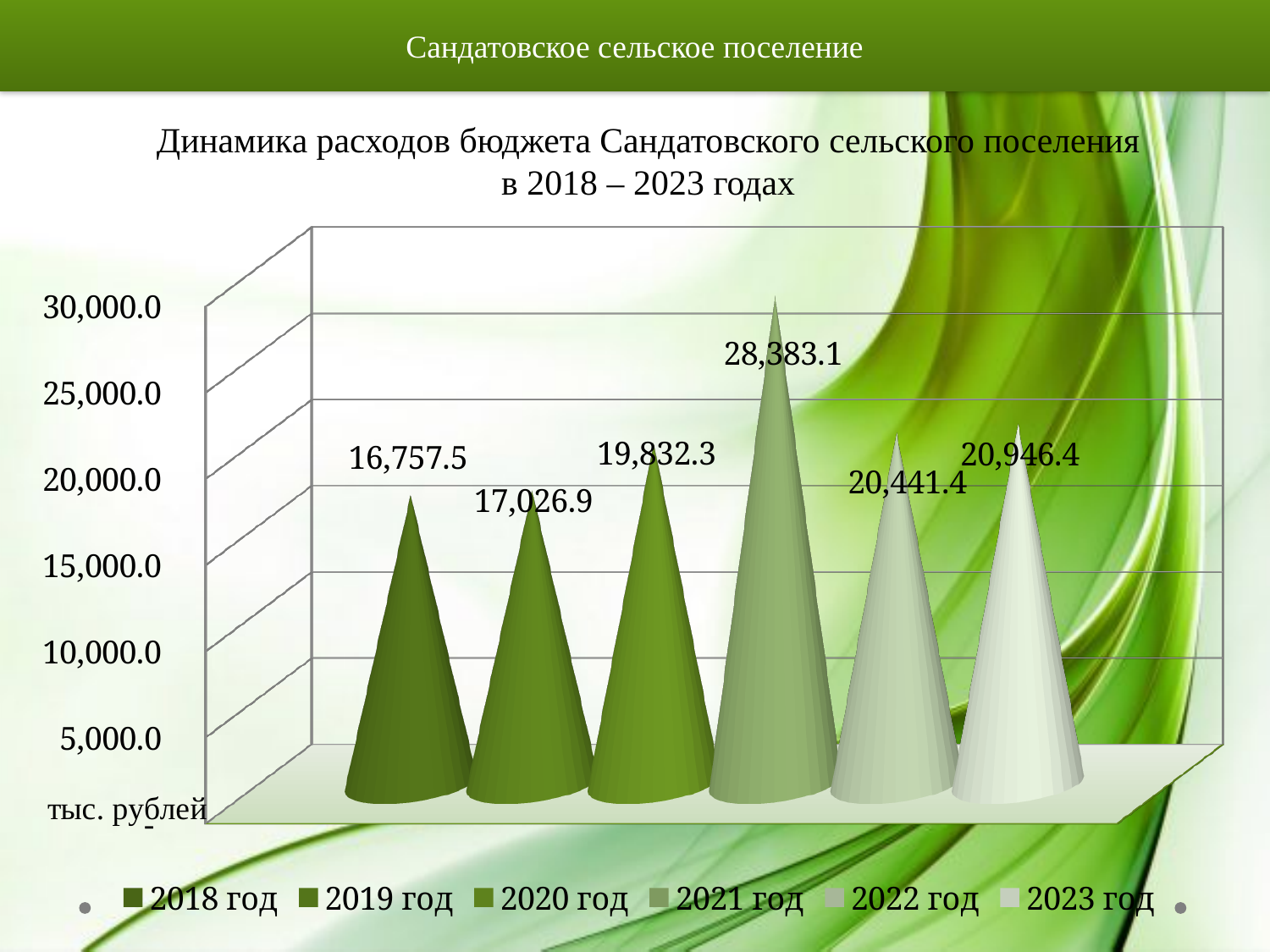
Which is larger, the value for 2020 год or the value for 2019 год? 2020 год What kind of chart is shown on the slide? bar chart What is the value for 2021 год? 28,383.1 What is the value for 2018 год? 16,757.5 What is the difference between the values for 2023 год and 2022 год? 505.0 Which year has the highest value? 2021 год Is the value for 2021 год greater or less than 25,000.0? greater What unit is indicated on the chart's axis? тыс. рублей Which year has the lowest value? 2018 год How many series does the legend list? 6 What is the difference between the values for 2021 год and 2020 год? 8,550.8 What is the value for 2023 год? 20,946.4